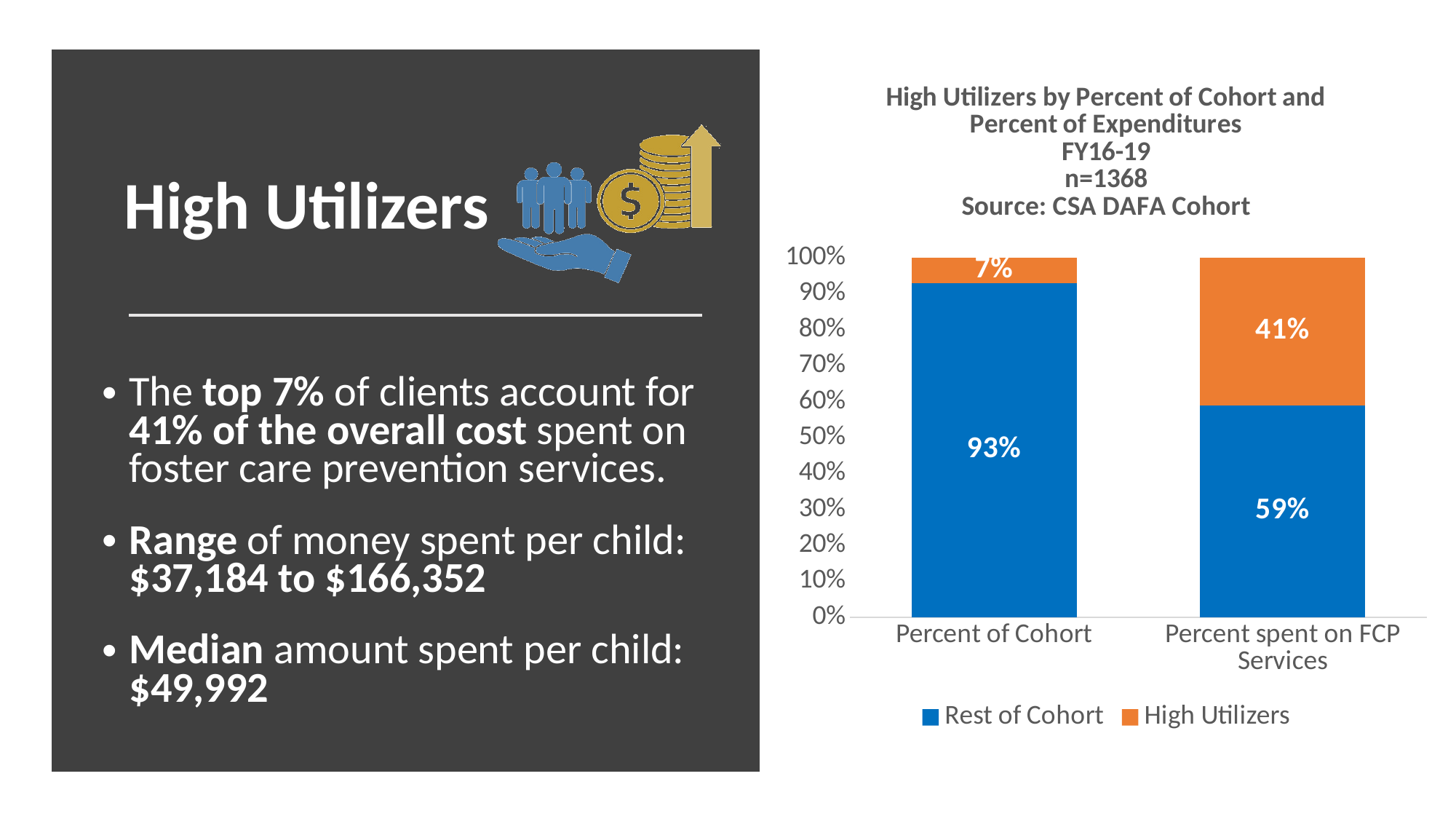
How many categories are shown on the x axis? 2 What is the difference between the High Utilizers share of Percent spent on FCP Services and their share of Percent of Cohort? 34% What percentage of spending on FCP Services is attributed to High Utilizers? 41% What percentage of the cohort is made up of High Utilizers? 7% What is the total of the stacked bar for Percent of Cohort? 100% Which category has the larger High Utilizers share: Percent of Cohort or Percent spent on FCP Services? Percent spent on FCP Services What is the Rest of Cohort value for Percent spent on FCP Services? 59% What is the Rest of Cohort value for Percent of Cohort? 93% What kind of chart is shown on the slide? Stacked bar chart Which series is shown in orange? High Utilizers How many series does the legend list? 2 What is the sample size (n) stated in the chart title? n=1368